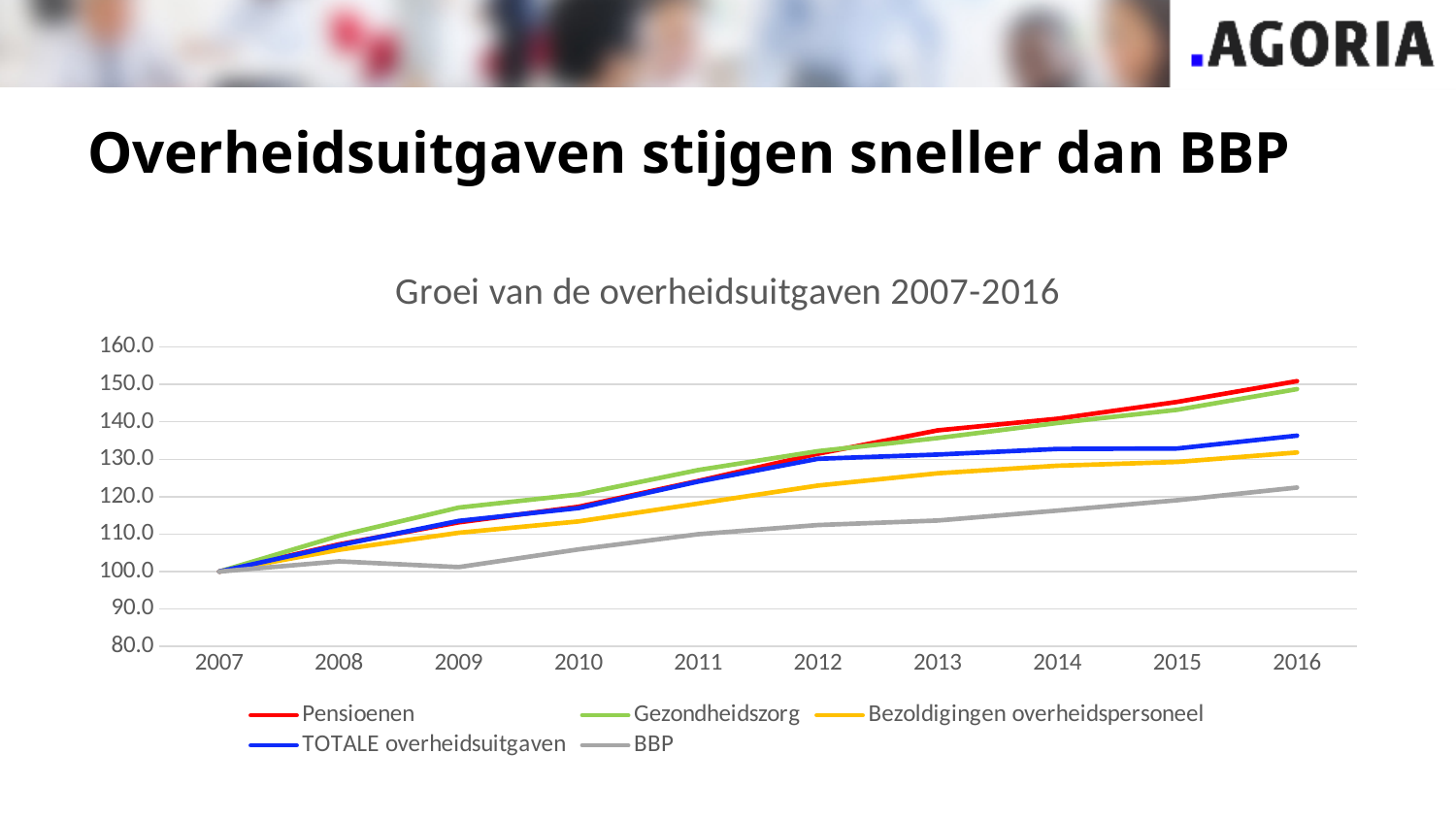
Does the Gezondheidszorg line rise or fall from 2007 to 2016? rise How many series does the legend list? 5 In 2016, which is larger: TOTALE overheidsuitgaven or BBP? TOTALE overheidsuitgaven Which series has the lowest value in 2016? BBP How many years are shown on the x axis? 10 Which series has the highest value in 2016? Pensioenen What is the value for Pensioenen in 2007? 100.0 What is the chart's title? Groei van de overheidsuitgaven 2007-2016 Which colour is used for the BBP line? grey What kind of chart is shown on the slide? line chart Is the value for BBP in 2009 greater or less than 110.0? less Is the value for Pensioenen in 2016 greater or less than 140.0? greater